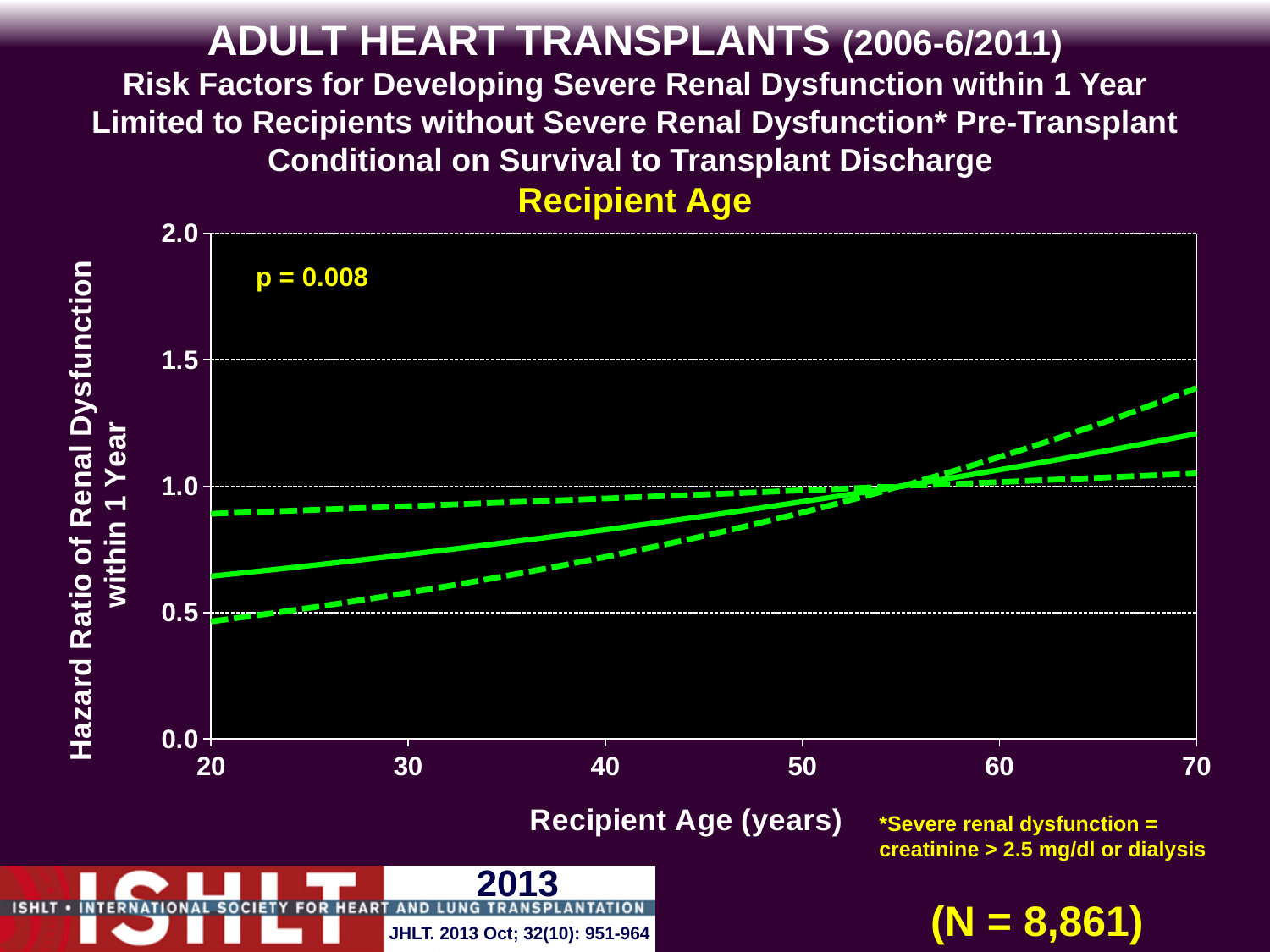
Is the hazard ratio on the solid line larger at recipient age 20 or at recipient age 70? 70 Is the hazard ratio on the solid line at recipient age 20 greater or less than 1.0? less Is the hazard ratio on the solid line at recipient age 70 greater or less than 1.5? less What is the label of the x axis? Recipient Age (years) Does the solid line for hazard ratio rise or fall as recipient age increases from 20 to 70 years? rise What kind of chart is shown on the slide? line chart What p-value is printed on the chart? p = 0.008 How many lines are plotted on the chart? 3 Is the hazard ratio on the solid line at recipient age 70 greater or less than 1.0? greater